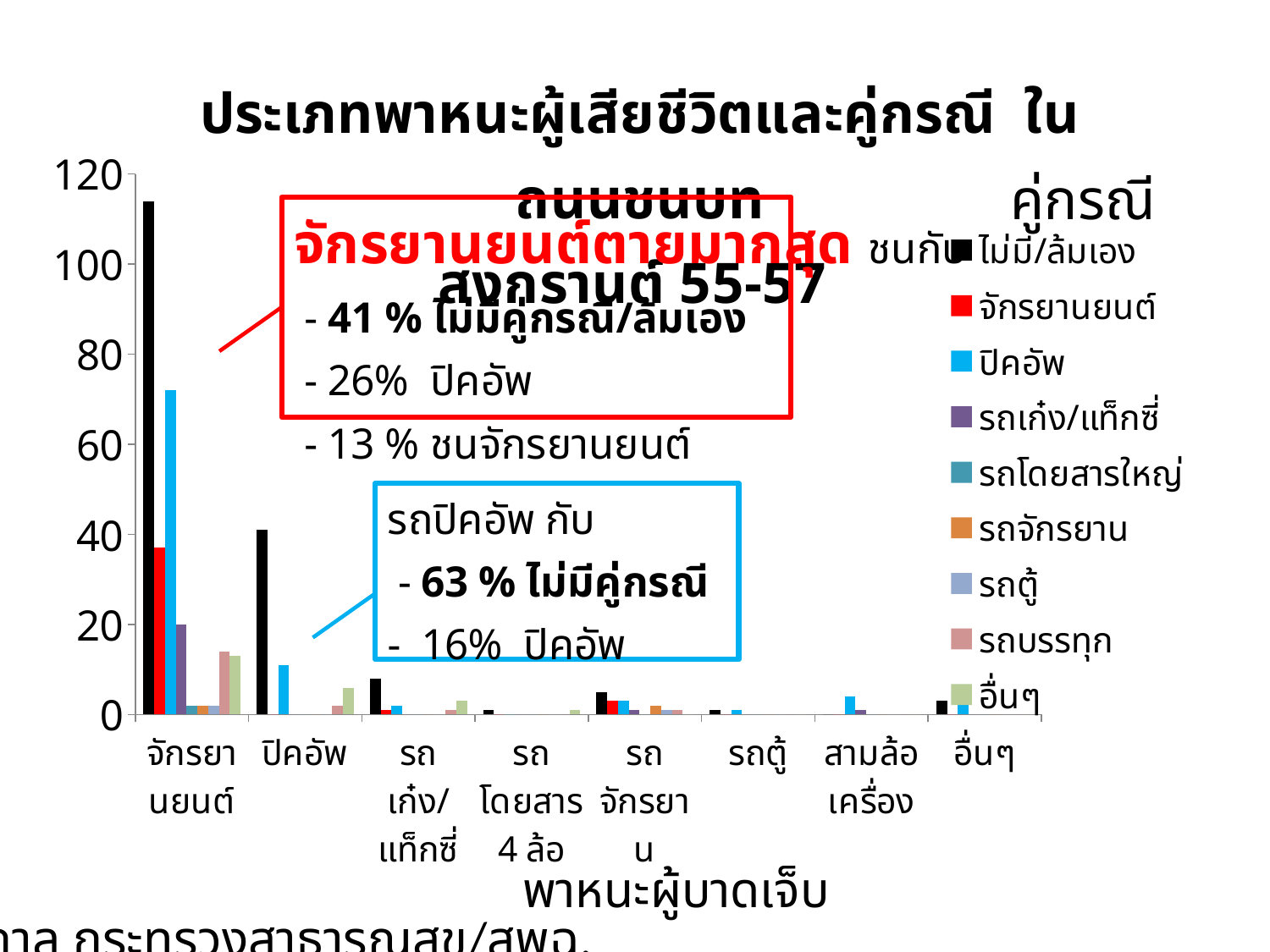
What is the x-axis title of the chart? พาหนะผู้บาดเจ็บ What kind of chart is shown on the slide? bar chart What is the title of the legend? คู่กรณี Is the ไม่มี/ล้มเอง value for ปิคอัพ greater or less than 60? less In the จักรยานยนต์ category, which is larger: the จักรยานยนต์ value or the ปิคอัพ value? ปิคอัพ In the ปิคอัพ category, which is larger: the ไม่มี/ล้มเอง value or the ปิคอัพ value? ไม่มี/ล้มเอง Is the ปิคอัพ value for จักรยานยนต์ greater or less than 60? greater How many series does the legend list? 9 How many vehicle categories are shown along the x axis? 8 Which category has the tallest bar in the chart? จักรยานยนต์ Which series has the highest value in the จักรยานยนต์ category? ไม่มี/ล้มเอง Is the ไม่มี/ล้มเอง value for จักรยานยนต์ greater or less than 100? greater